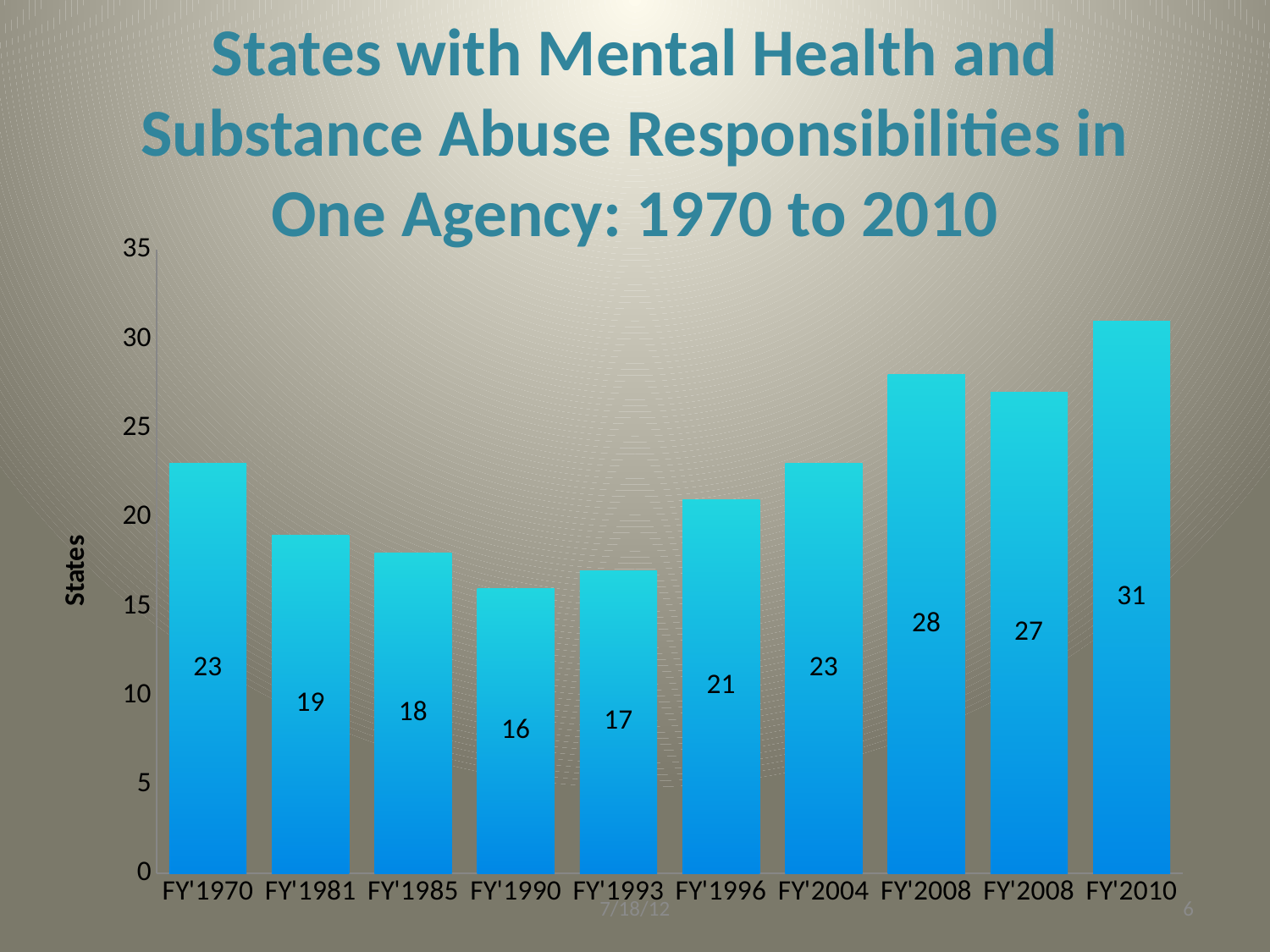
Which is larger, the value for FY'1970 or the value for FY'1981? FY'1970 What is the label on the vertical axis? States Is the value for FY'1993 greater or less than 20? less What is the value for FY'1990? 16 What is the value for FY'1970? 23 Which fiscal year has the lowest value? FY'1990 What is the difference between the values for FY'2010 and FY'1990? 15 What is the value for FY'2010? 31 Which fiscal year has the highest value? FY'2010 What is the value for FY'1996? 21 What kind of chart is shown on the slide? bar chart How many bars are shown in the chart? 10